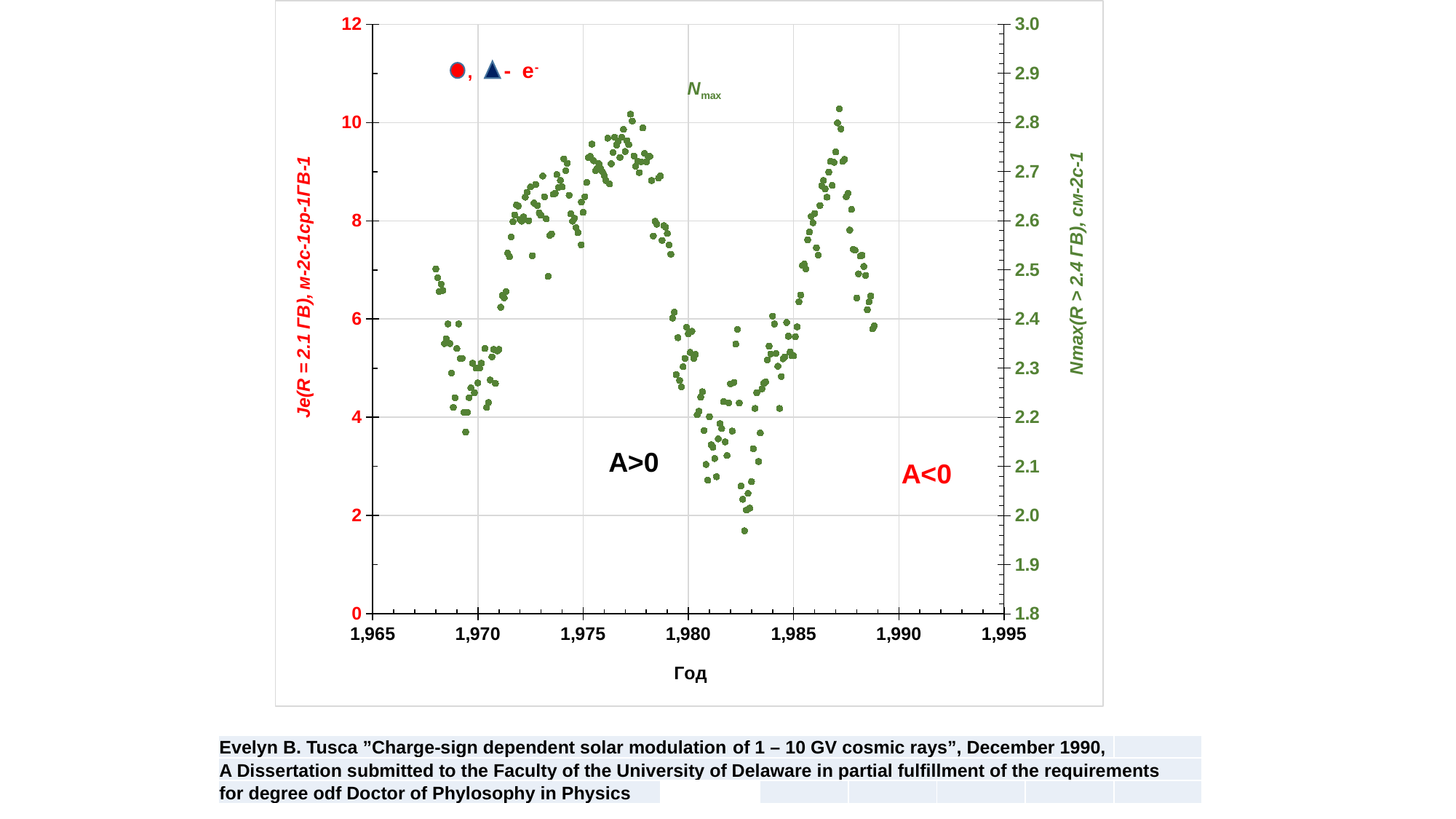
On the right-hand axis, is the value of the points around 1977 greater or less than 2.6? greater On the right-hand axis, is the value of the points around 1982 greater or less than 2.4? less Between 1983 and 1987, do the plotted values rise or fall? rise Is the value of the points around 1977 larger or smaller than the value of the points around 1970? larger On the right-hand axis, is the lowest plotted point greater or less than 2.2? less Between 1977 and 1982, do the plotted values rise or fall? fall Between 1970 and 1977, do the plotted values rise or fall? rise What two annotations are written inside the plot area to mark the polarity regions? A>0 and A<0 What kind of chart is shown on the slide? scatter chart What is the label of the x axis? Год Between which two x-axis tick labels does the lowest plotted point fall? 1,980 and 1,985